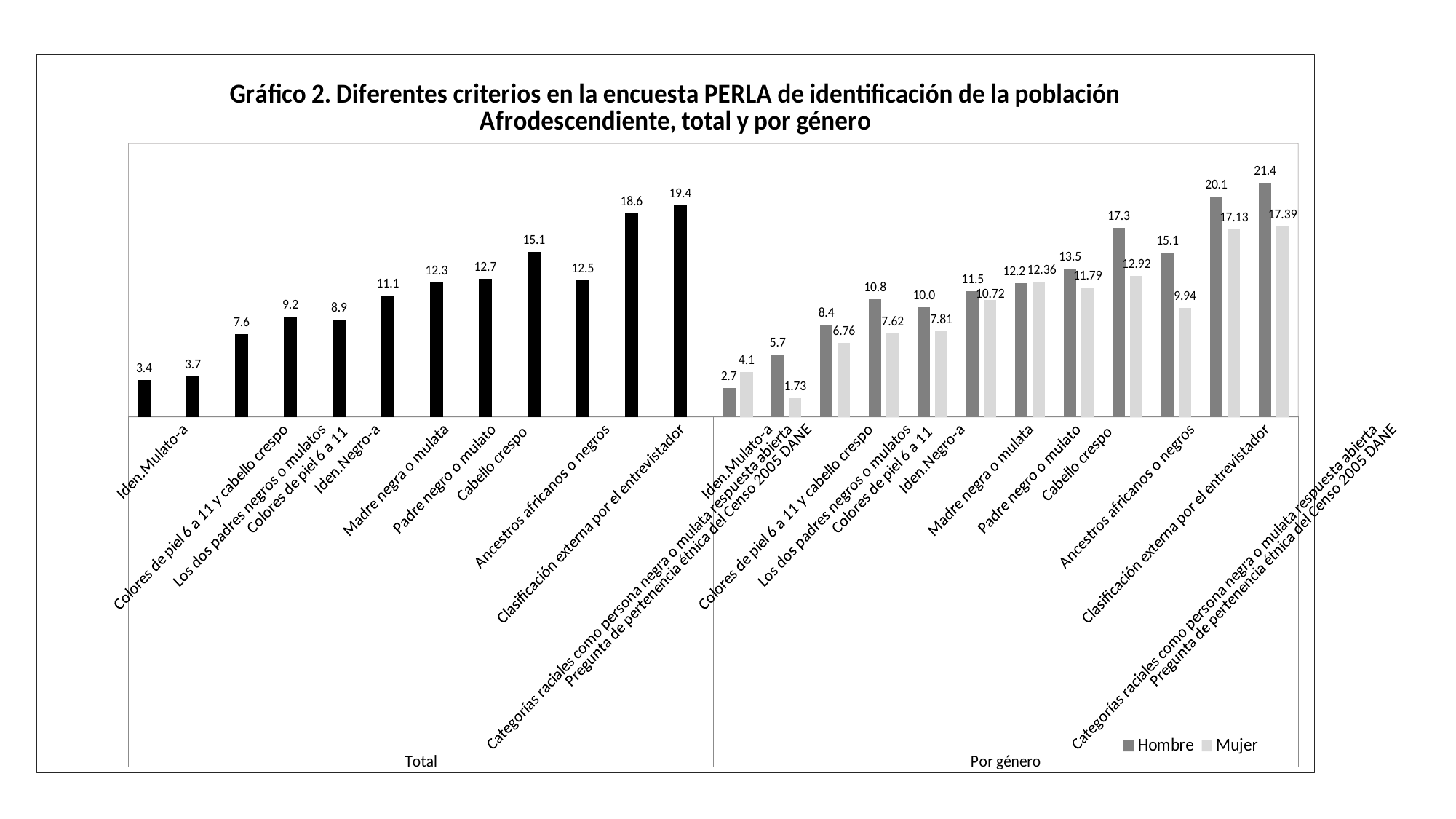
In the Por género group, what is the Mujer value for Cabello crespo? 11.79 In the Por género group, which is larger for Ancestros africanos o negros: the Hombre value or the Mujer value? Hombre What are the two series named in the legend? Hombre and Mujer In the Total group, what is the value for Cabello crespo? 12.7 In the Total group, what is the difference between Clasificación externa por el entrevistador and Cabello crespo? 0.2 In the Por género group, which category has the lowest Mujer value? Colores de piel 6 a 11 y cabello crespo In the Por género group, what is the Hombre value for Clasificación externa por el entrevistador? 15.1 In the Total group, what is the value for Iden.Negro-a? 8.9 In the Total group, which category has the highest value? Pregunta de pertenencia étnica del Censo 2005 DANE What type of chart is shown on the slide? bar chart In the Total group, which category has the lowest value? Iden.Mulato-a How many series does the legend list? 2